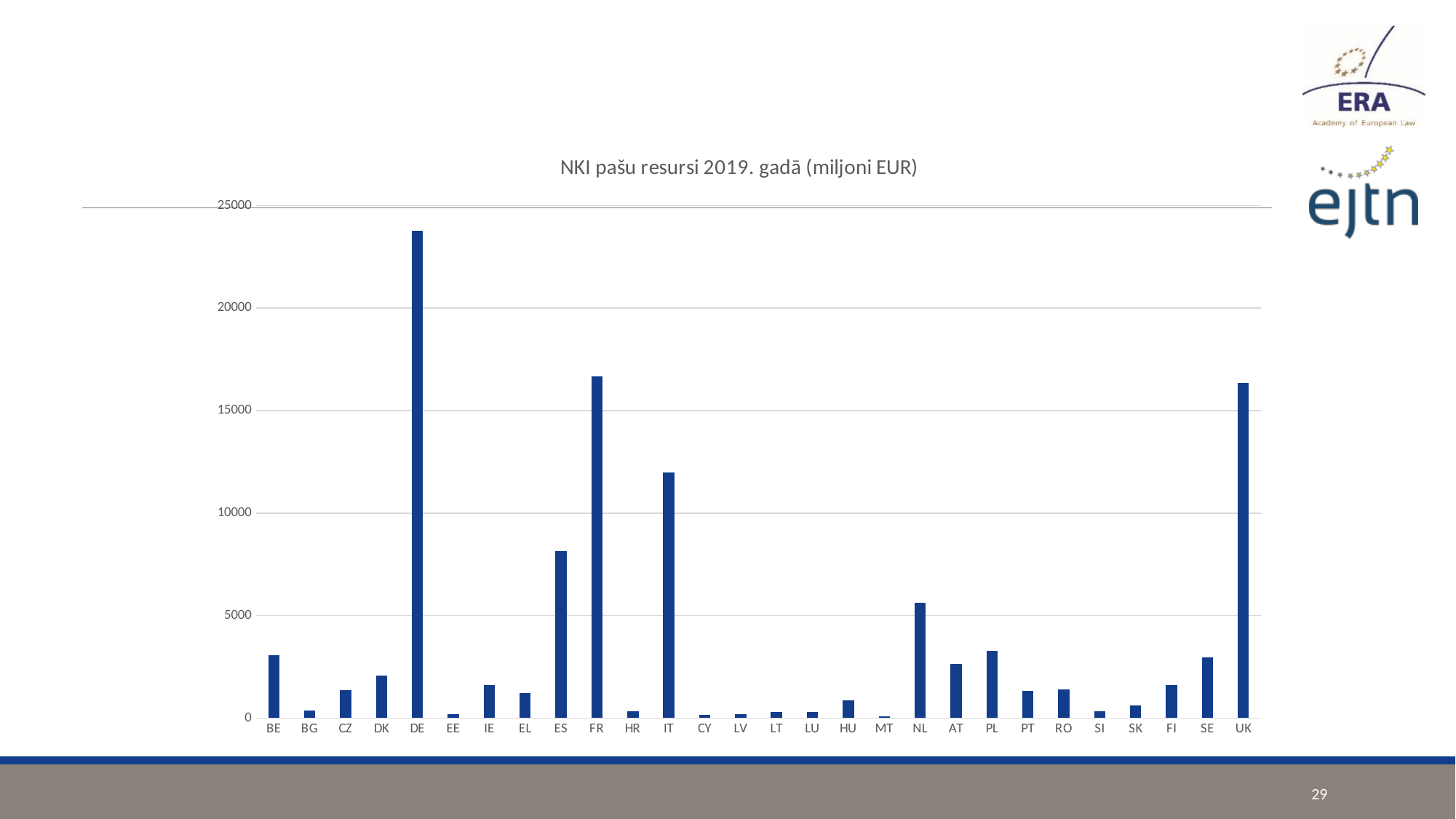
Is the value for IT greater or less than 10000? greater Is the value for NL greater or less than 5000? greater What is the title of the chart? NKI pašu resursi 2019. gadā (miljoni EUR) Which country has the highest value in the chart? DE Which has a larger value, ES or NL? ES How many countries are shown on the x axis of the chart? 28 Which country has the lowest value in the chart? MT Is the value for DE greater or less than 20000? greater Which has a larger value, FR or IT? FR What type of chart is shown on the slide? bar chart